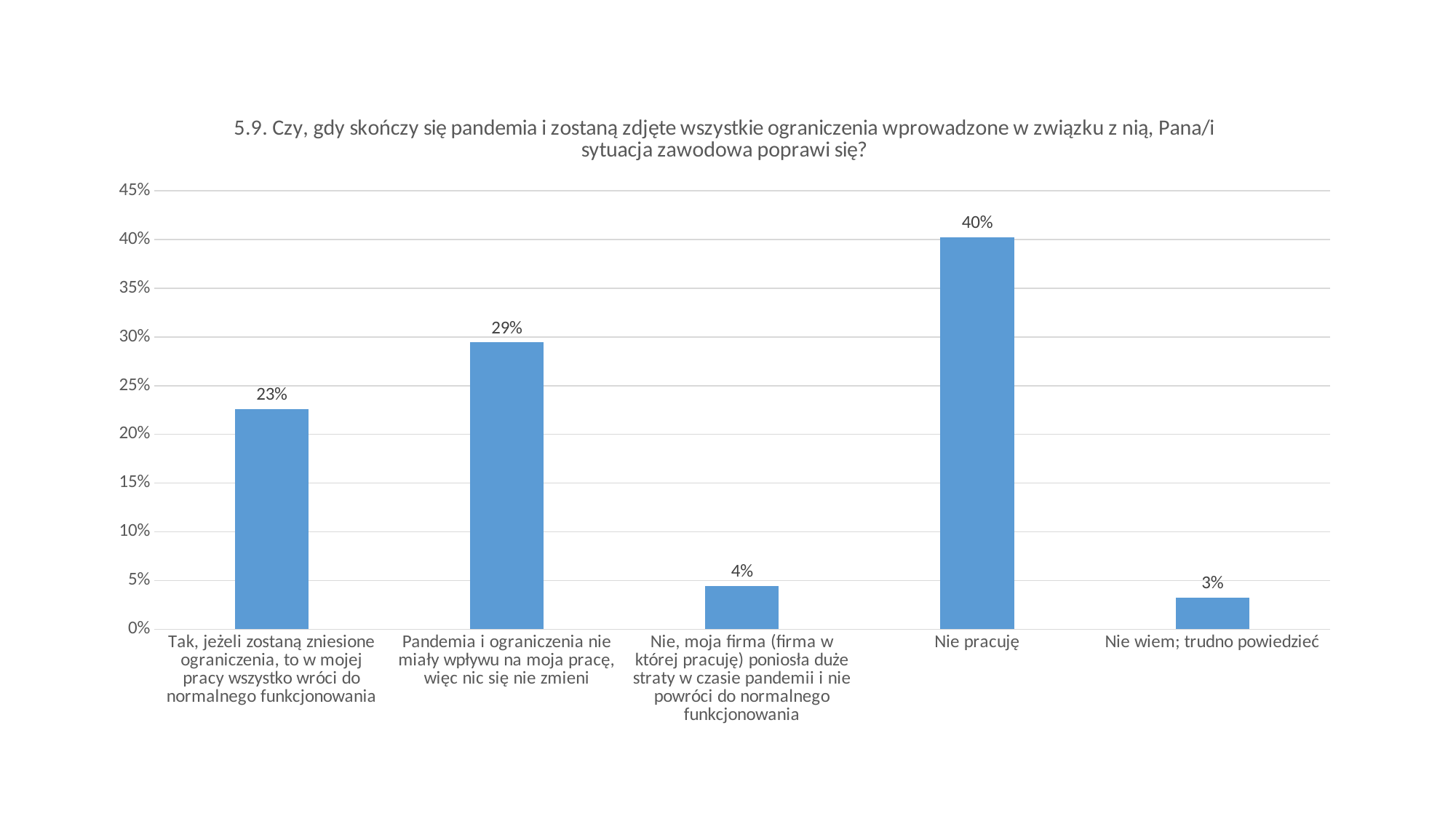
What is the value for "Pandemia i ograniczenia nie miały wpływu na moja pracę, więc nic się nie zmieni"? 29% Is the value for "Nie pracuję" greater or less than 35%? greater What is the highest value shown on the vertical axis? 45% What kind of chart is shown on the slide? bar chart What is the value for "Tak, jeżeli zostaną zniesione ograniczenia, to w mojej pracy wszystko wróci do normalnego funkcjonowania"? 23% Which is larger: the value for "Tak, jeżeli zostaną zniesione ograniczenia, to w mojej pracy wszystko wróci do normalnego funkcjonowania" or the value for "Nie, moja firma (firma w której pracuję) poniosła duże straty w czasie pandemii i nie powróci do normalnego funkcjonowania"? Tak, jeżeli zostaną zniesione ograniczenia, to w mojej pracy wszystko wróci do normalnego funkcjonowania What is the value for "Nie pracuję"? 40% What is the value for "Nie wiem; trudno powiedzieć"? 3% Which category has the highest value? Nie pracuję Which category has the lowest value? Nie wiem; trudno powiedzieć How many categories are shown in the chart? 5 What is the difference between the values for "Nie pracuję" and "Pandemia i ograniczenia nie miały wpływu na moja pracę, więc nic się nie zmieni"? 11%